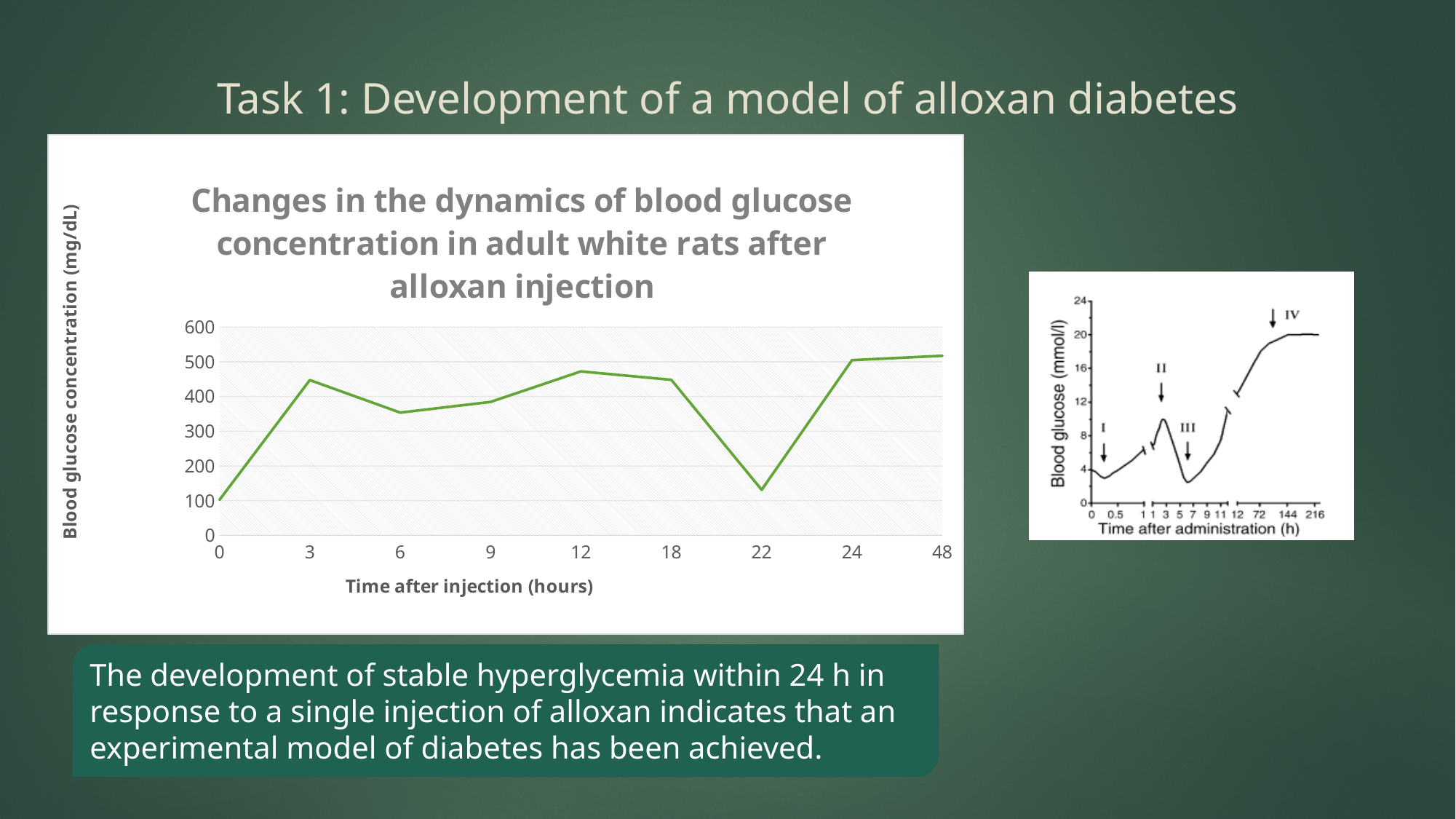
In the left chart on blood glucose after alloxan injection, is the value at 6 hours greater or less than 400? less In the left chart titled 'Changes in the dynamics of blood glucose concentration in adult white rats after alloxan injection', what kind of chart is shown? Line chart In the left chart on blood glucose after alloxan injection, at which time point is the blood glucose concentration lowest? 0 hours In the left chart on blood glucose after alloxan injection, which is larger: the value at 18 hours or the value at 22 hours? 18 hours In the left chart on blood glucose after alloxan injection, is the value at 3 hours greater or less than 400? greater In the left chart on blood glucose after alloxan injection, which is larger: the value at 12 hours or the value at 6 hours? 12 hours In the left chart on blood glucose after alloxan injection, how many time points are plotted along the x axis? 9 In the left chart on blood glucose after alloxan injection, is the value at 22 hours greater or less than 200? less In the left chart on blood glucose after alloxan injection, what is the title of the x axis? Time after injection (hours) In the left chart on blood glucose after alloxan injection, does the value rise or fall between 18 hours and 22 hours? Fall In the left chart on blood glucose after alloxan injection, what is the title of the y axis? Blood glucose concentration (mg/dL)